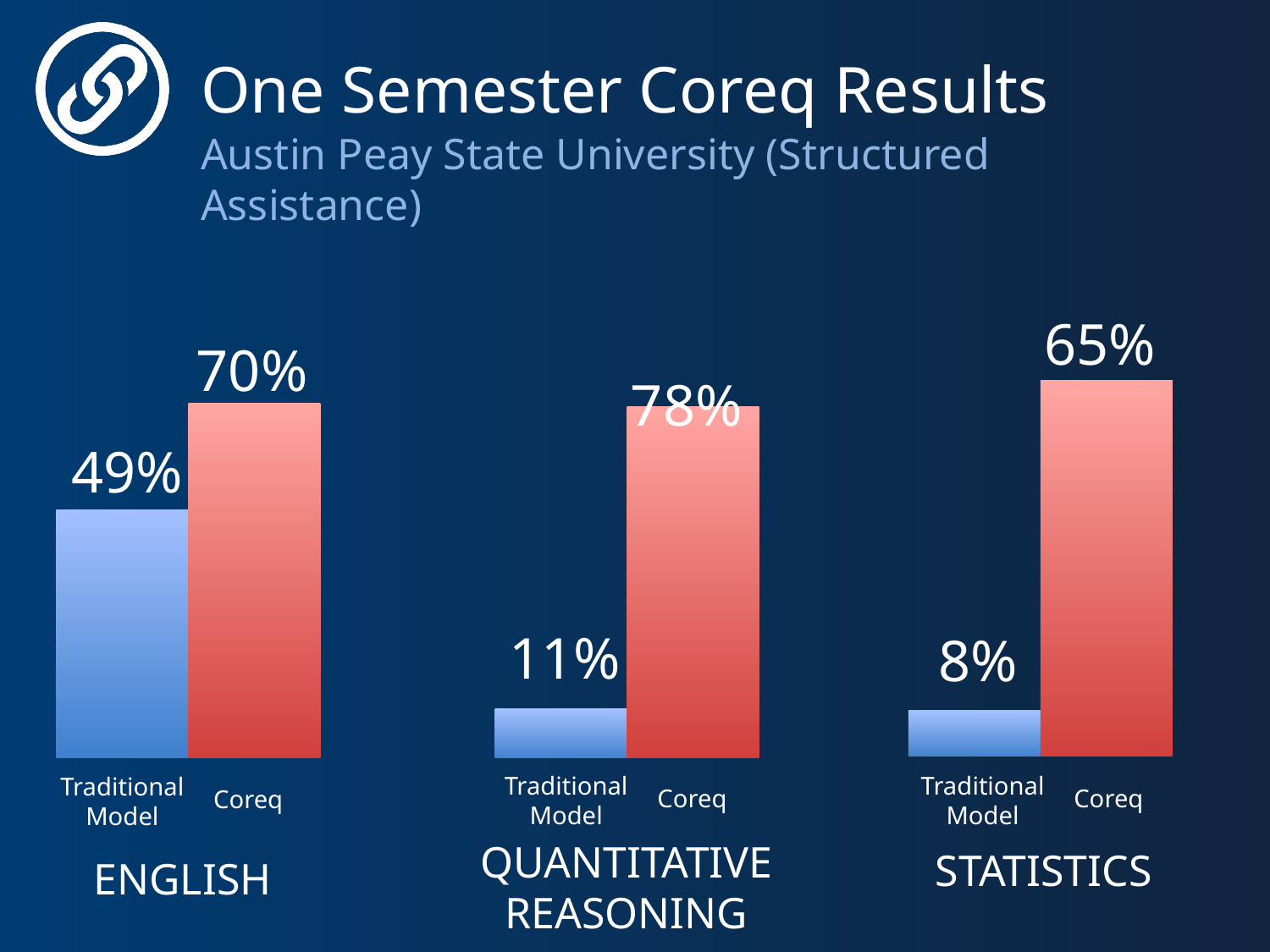
In the Statistics chart, what is the difference between the Coreq value and the Traditional Model value? 57% In the Statistics chart, what is the value for the Traditional Model? 8% In the Quantitative Reasoning chart, what is the value for Coreq? 78% In the Quantitative Reasoning chart, what is the difference between the Coreq value and the Traditional Model value? 67% How many bars are shown in the Quantitative Reasoning chart? 2 In the English chart, which is larger, the Traditional Model or Coreq? Coreq In the Quantitative Reasoning chart, what is the value for the Traditional Model? 11% In the English chart, what is the value for the Traditional Model? 49% What kind of chart is used for the English results? Bar chart In the Statistics chart, what is the value for Coreq? 65% In the English chart, what is the value for Coreq? 70% In the Statistics chart, which category has the lowest value? Traditional Model